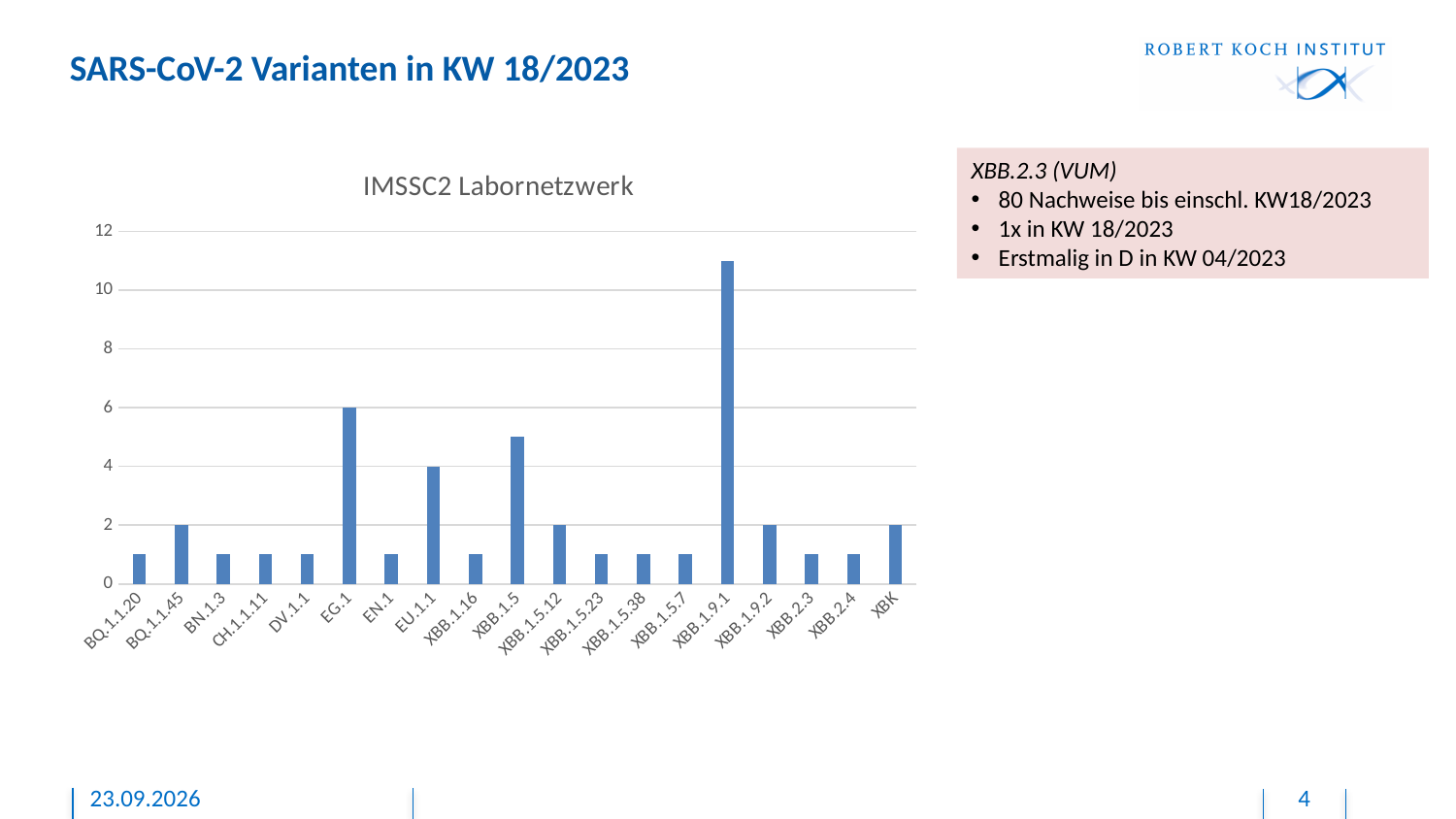
What is the difference between the values for EG.1 and EU.1.1? 2 Is the value for XBB.1.9.1 greater or less than 10? greater What is the value for BQ.1.1.45? 2 What is the value for XBK? 2 What is the value for EG.1? 6 Is the value for BQ.1.1.20 greater or less than 2? less What is the title of the chart? IMSSC2 Labornetzwerk What kind of chart is shown on the slide? bar chart Which variant has the highest bar in the chart? XBB.1.9.1 What is the value for EU.1.1? 4 How many variant categories are shown on the x axis of the chart? 19 Which is larger, the value for EG.1 or the value for XBB.1.5? EG.1